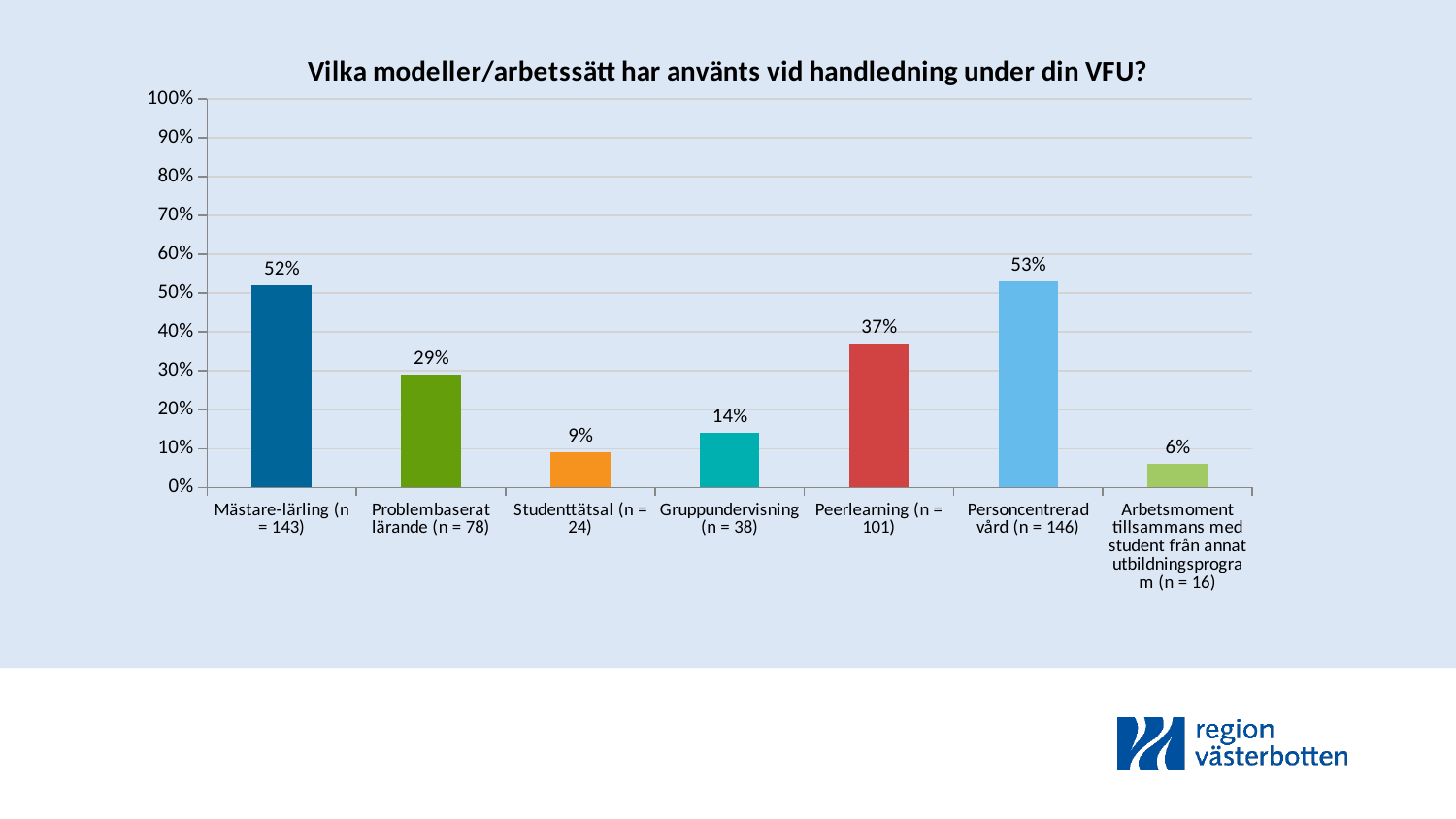
What is the title of the chart? Vilka modeller/arbetssätt har använts vid handledning under din VFU? How many categories are shown on the x axis? 7 What is the value for Gruppundervisning (n = 38)? 14% Which is larger, the value for Peerlearning (n = 101) or the value for Problembaserat lärande (n = 78)? Peerlearning (n = 101) Which category has the lowest value? Arbetsmoment tillsammans med student från annat utbildningsprogram (n = 16) Which category has the highest value? Personcentrerad vård (n = 146) What is the value for Mästare-lärling (n = 143)? 52% What is the value for Studenttätsal (n = 24)? 9% Is the value for Personcentrerad vård (n = 146) greater or less than 50%? greater What kind of chart is shown on the slide? Bar chart What is the value for Peerlearning (n = 101)? 37% What is the difference between the values for Problembaserat lärande (n = 78) and Gruppundervisning (n = 38)? 15%